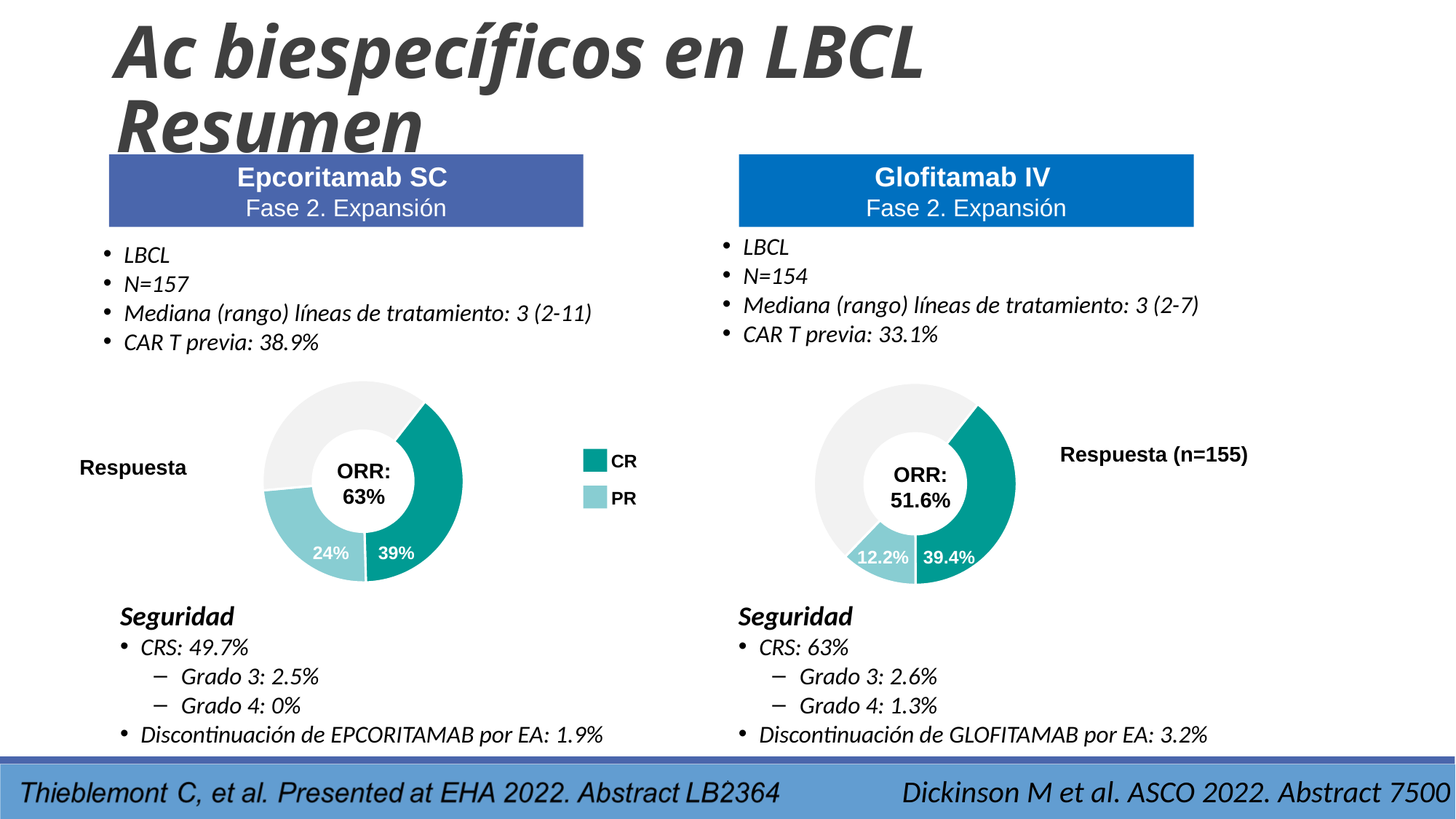
In the Epcoritamab SC donut chart on the left, what is the difference between the CR and PR values? 15% In the Glofitamab IV donut chart on the right, which labelled slice is larger, CR or PR? CR In the Epcoritamab SC donut chart on the left, which labelled slice is larger, CR or PR? CR In the Epcoritamab SC donut chart on the left, what is the PR value? 24% In the Glofitamab IV donut chart on the right, what is the PR value? 12.2% In the Glofitamab IV donut chart on the right, what is the CR value? 39.4% What type of chart is used to show the response data for each drug? Donut (pie) chart In the Glofitamab IV donut chart on the right, what is the difference between the CR and PR values? 27.2% How many entries does the legend between the two donut charts list? 2 In the Epcoritamab SC donut chart on the left, what is the CR value? 39% What ORR is shown in the centre of the Glofitamab IV donut chart on the right? 51.6% What ORR is shown in the centre of the Epcoritamab SC donut chart on the left? 63%